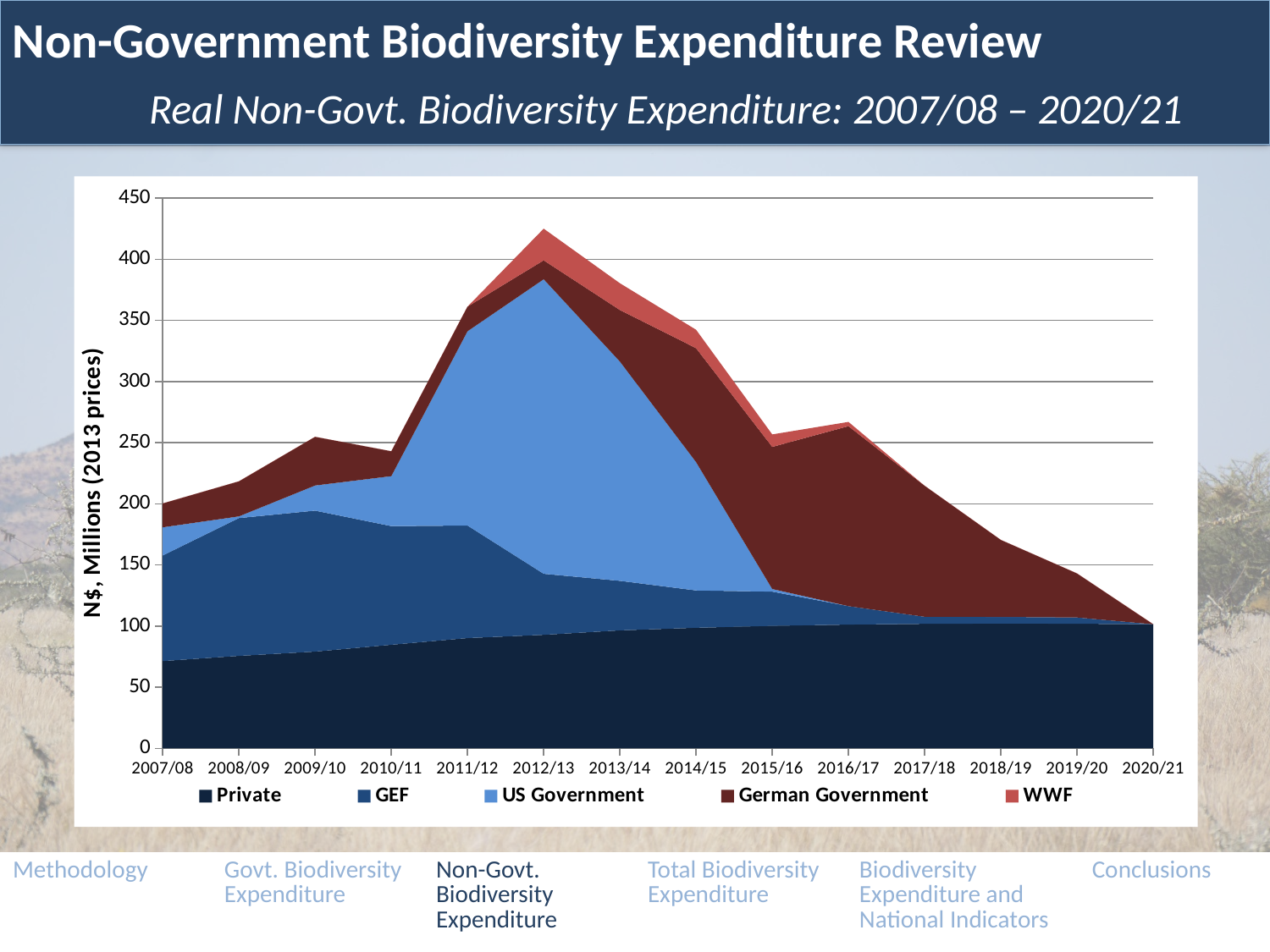
Does the total expenditure rise or fall from 2012/13 to 2020/21? Fall What is the label on the vertical axis? N$, Millions (2013 prices) Which year has the larger total expenditure, 2012/13 or 2016/17? 2012/13 Is the total expenditure in 2011/12 greater or less than 300? greater How many series does the legend list? 5 Is the total expenditure in 2012/13 greater or less than 400? greater Is the total expenditure in 2020/21 greater or less than 150? less What kind of chart is shown on the slide? Stacked area chart How many financial years are shown along the x axis? 14 In which year does the total non-government biodiversity expenditure reach its highest point? 2012/13 In which year is the total non-government biodiversity expenditure lowest? 2020/21